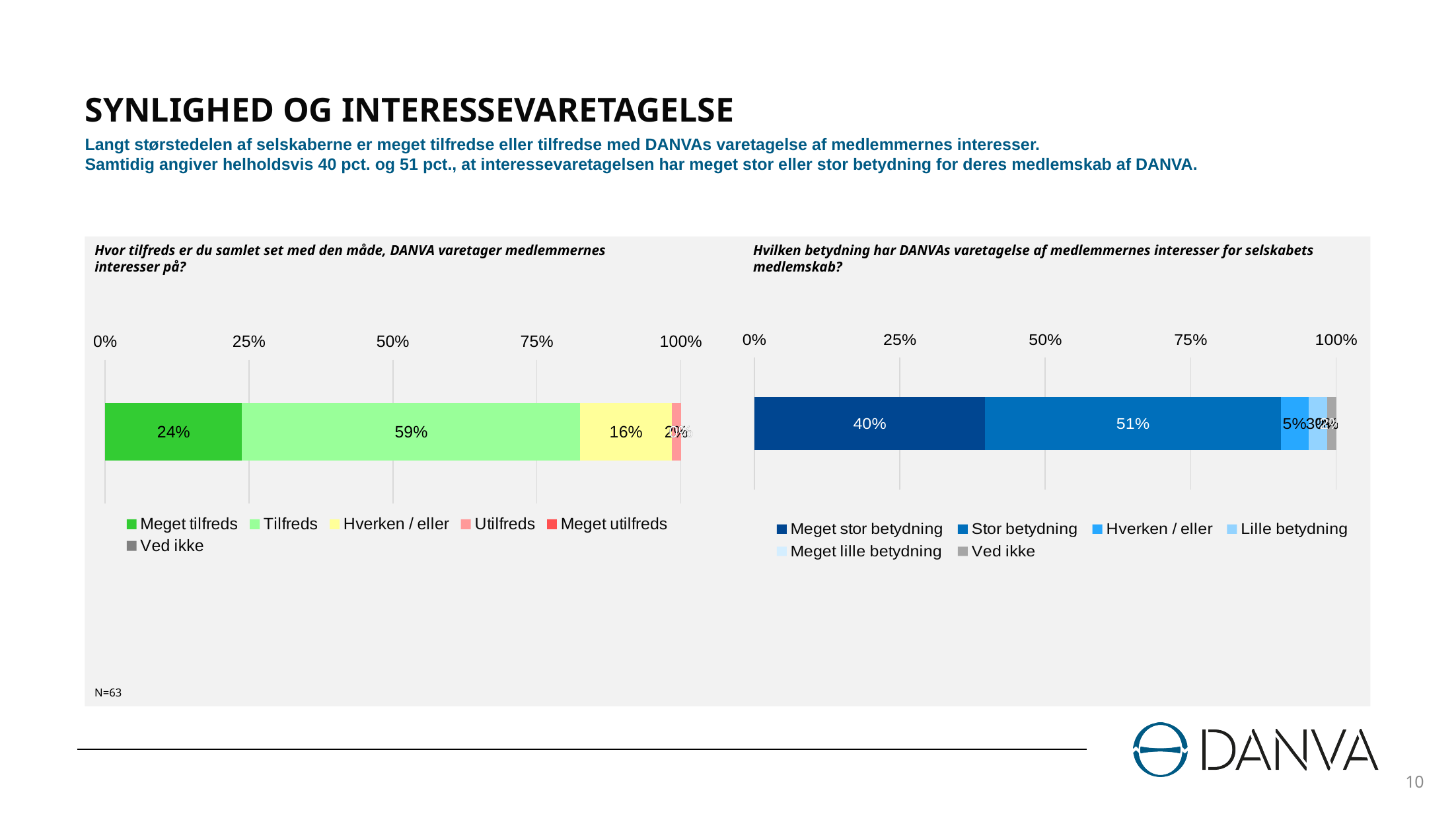
In the right chart (Hvilken betydning har DANVAs varetagelse...), what percentage of respondents answered 'Meget stor betydning'? 40% In the right chart (Hvilken betydning har DANVAs varetagelse...), which response category has the largest share? Stor betydning In the left chart (Hvor tilfreds er du samlet set...), how many percentage points larger is 'Tilfreds' than 'Meget tilfreds'? 35 percentage points In the right chart (Hvilken betydning har DANVAs varetagelse...), what percentage of respondents answered 'Stor betydning'? 51% In the left chart (Hvor tilfreds er du samlet set...), which is larger: 'Meget tilfreds' or 'Hverken / eller'? Meget tilfreds In the left chart (Hvor tilfreds er du samlet set...), which response category has the largest share? Tilfreds In the left chart (Hvor tilfreds er du samlet set...), what percentage of respondents answered 'Meget tilfreds'? 24% In the right chart (Hvilken betydning har DANVAs varetagelse...), how many percentage points larger is 'Stor betydning' than 'Meget stor betydning'? 11 percentage points How many entries does the legend of the right chart (Hvilken betydning har DANVAs varetagelse...) list? 6 In the left chart (Hvor tilfreds er du samlet set...), what percentage of respondents answered 'Hverken / eller'? 16% In the left chart (Hvor tilfreds er du samlet set...), what percentage of respondents answered 'Tilfreds'? 59% What kind of chart is the left chart (Hvor tilfreds er du samlet set...)? Stacked bar chart